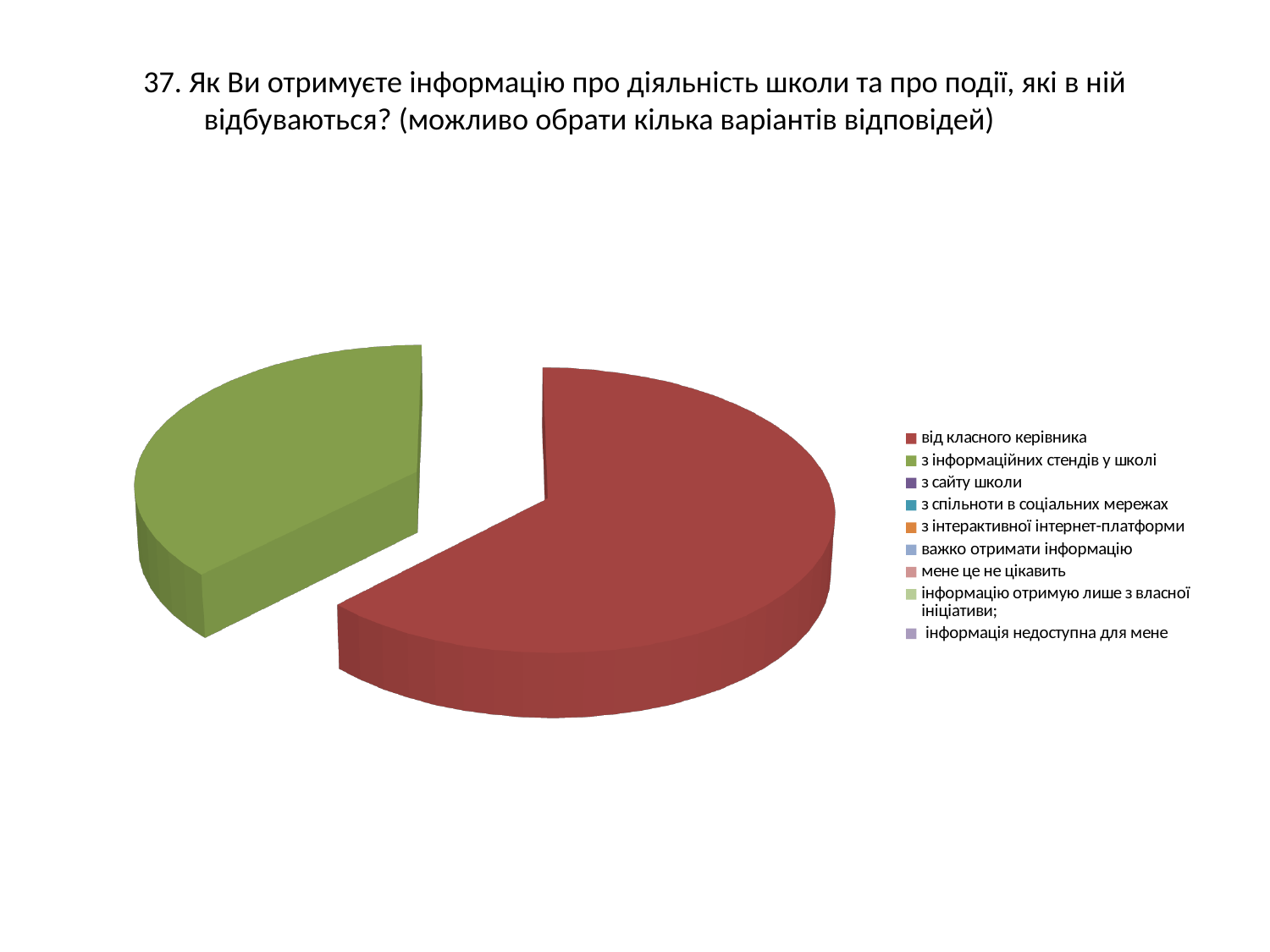
Which colour is used for the "з інформаційних стендів у школі" slice? green Which legend entry is listed last? інформація недоступна для мене Which slice is larger: "від класного керівника" or "з інформаційних стендів у школі"? від класного керівника Is the share of the "від класного керівника" slice greater or less than 50%? greater What kind of chart is shown on the slide? pie chart Is the share of the "з інформаційних стендів у школі" slice greater or less than 50%? less How many slices are visible in the pie? 2 How many entries does the legend list? 9 Which colour is used for the "від класного керівника" slice? red Which category has the largest slice of the pie? від класного керівника